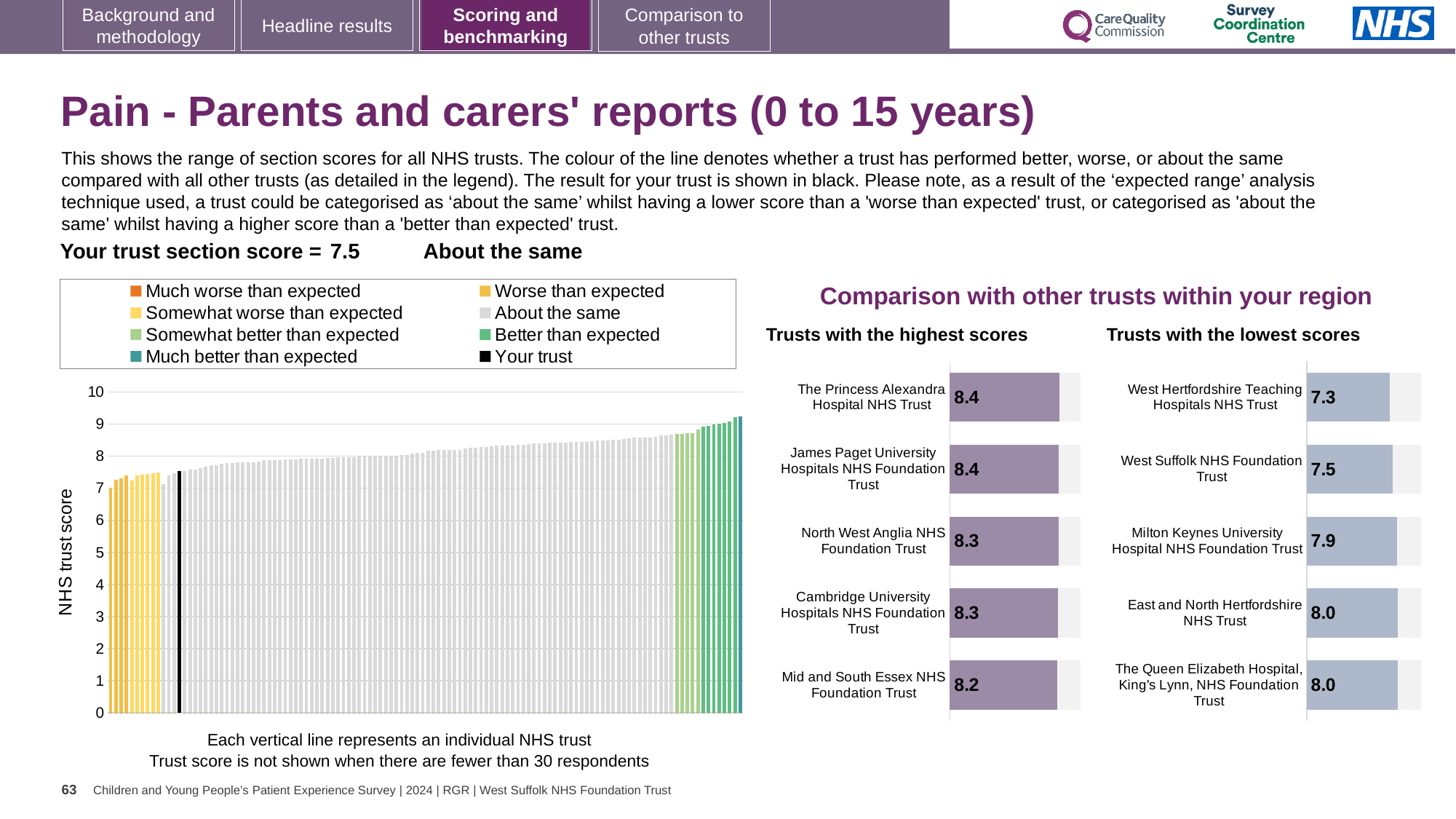
In the 'Trusts with the lowest scores' chart, how many trusts are shown? 5 How many entries does the legend of the NHS trust score chart on the left list? 8 In the 'Trusts with the lowest scores' chart, what is the score for West Hertfordshire Teaching Hospitals NHS Trust? 7.3 In the 'Trusts with the highest scores' chart, how many trusts are shown? 5 In the NHS trust score chart on the left, is the value of the leftmost (lowest) bar greater or less than 8? less In the 'Trusts with the highest scores' chart, which trust has the lowest score? Mid and South Essex NHS Foundation Trust What kind of chart is the NHS trust score chart on the left of the slide? Bar chart In the 'Trusts with the lowest scores' chart, which trust has the lowest score? West Hertfordshire Teaching Hospitals NHS Trust In the 'Trusts with the lowest scores' chart, which has the larger score: Milton Keynes University Hospital NHS Foundation Trust or West Suffolk NHS Foundation Trust? Milton Keynes University Hospital NHS Foundation Trust In the 'Trusts with the highest scores' chart, what is the score for North West Anglia NHS Foundation Trust? 8.3 In the 'Trusts with the highest scores' chart, what is the difference between the score for The Princess Alexandra Hospital NHS Trust and the score for Mid and South Essex NHS Foundation Trust? 0.2 In the NHS trust score chart on the left, do the values rise or fall from left to right? Rise